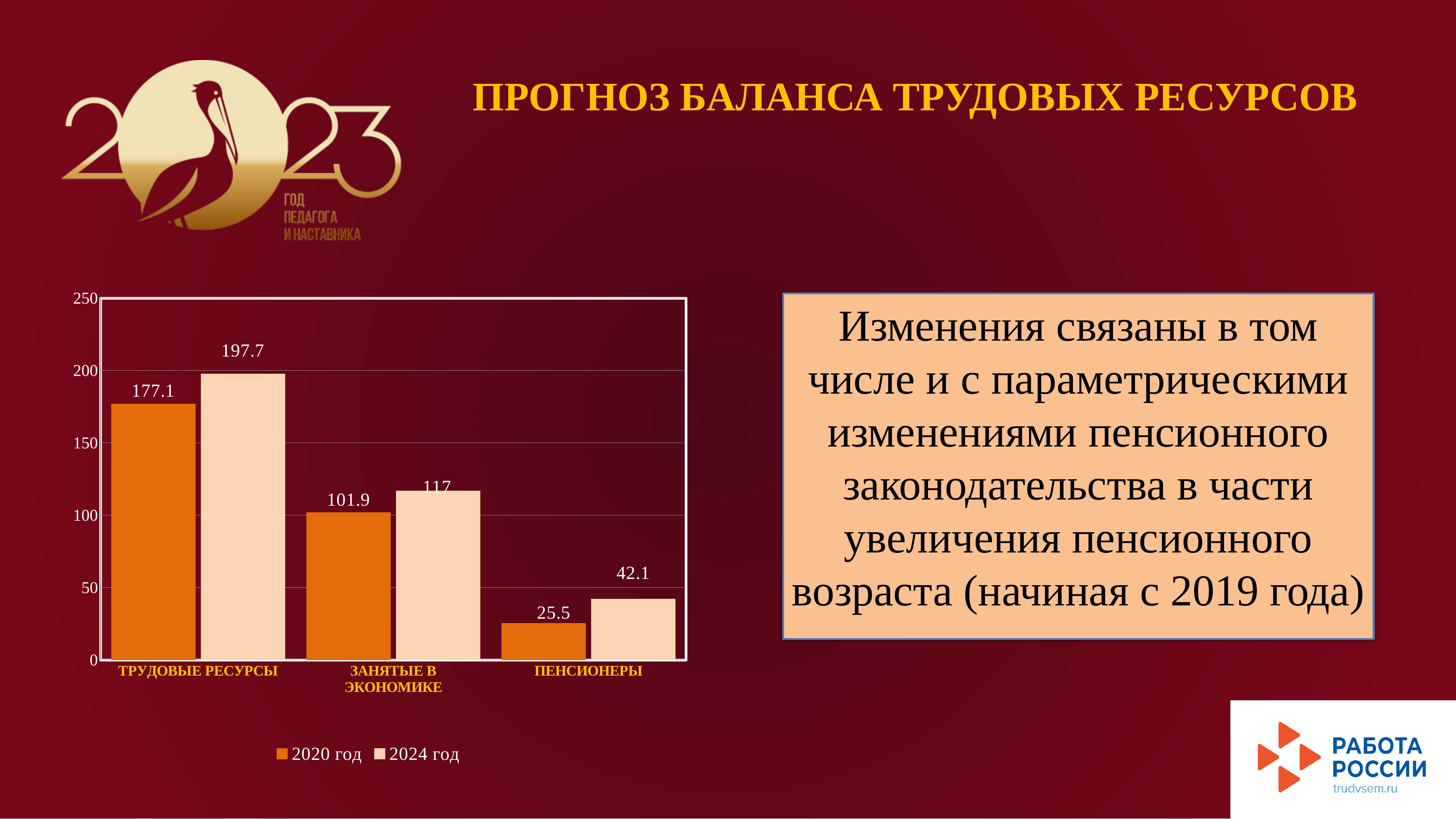
Which is larger for ЗАНЯТЫЕ В ЭКОНОМИКЕ: the 2020 год value or the 2024 год value? 2024 год How many categories are shown on the x axis of the chart? 3 Which category has the highest value in the 2024 год series? ТРУДОВЫЕ РЕСУРСЫ What is the value for ЗАНЯТЫЕ В ЭКОНОМИКЕ in the 2024 год series? 117 What is the value for ТРУДОВЫЕ РЕСУРСЫ in the 2024 год series? 197.7 How many series does the chart legend list? 2 What kind of chart is shown on the slide? bar chart What are the two series listed in the chart legend? 2020 год and 2024 год What is the value for ПЕНСИОНЕРЫ in the 2020 год series? 25.5 What is the value for ТРУДОВЫЕ РЕСУРСЫ in the 2020 год series? 177.1 Which category has the lowest value in the 2020 год series? ПЕНСИОНЕРЫ What is the difference between the 2024 год and 2020 год values for ПЕНСИОНЕРЫ? 16.6